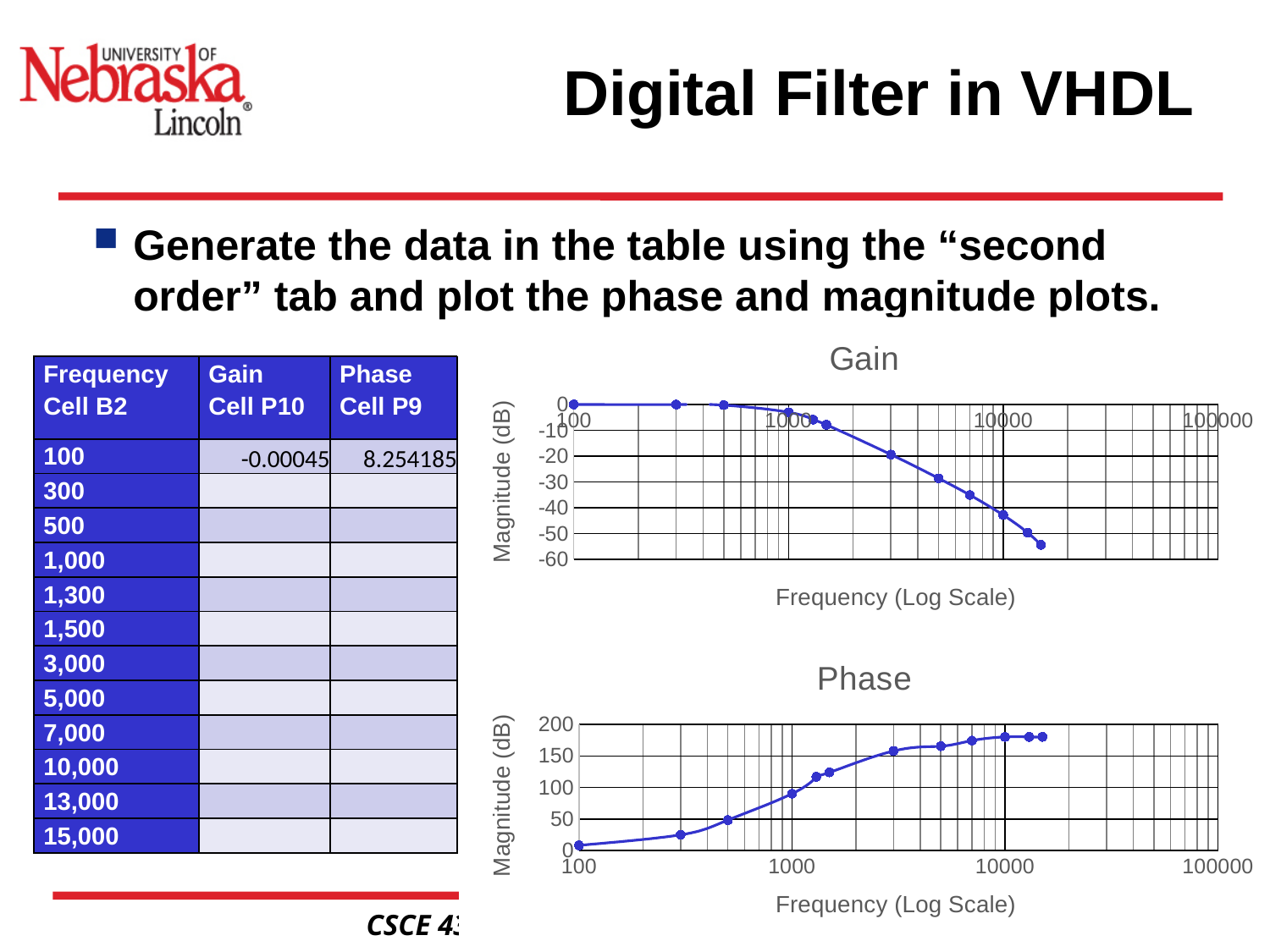
In the Gain chart, do the values rise or fall as frequency increases along the x axis? fall In the Phase chart, at which frequency is the plotted value lowest? 100 In the Phase chart, is the value at a frequency of 3000 greater or less than 150? greater In the Phase chart, is the value at a frequency of 300 greater or less than 50? less In the Gain chart, is the value at a frequency of 15000 greater or less than -50? less How many data points are plotted in the Gain chart? 12 What kind of chart is the Gain chart? line chart What is the x-axis label of the Phase chart? Frequency (Log Scale) In the Gain chart, at which frequency is the plotted value lowest? 15000 How many data points are plotted in the Phase chart? 12 In the Phase chart, do the values rise or fall as frequency increases along the x axis? rise